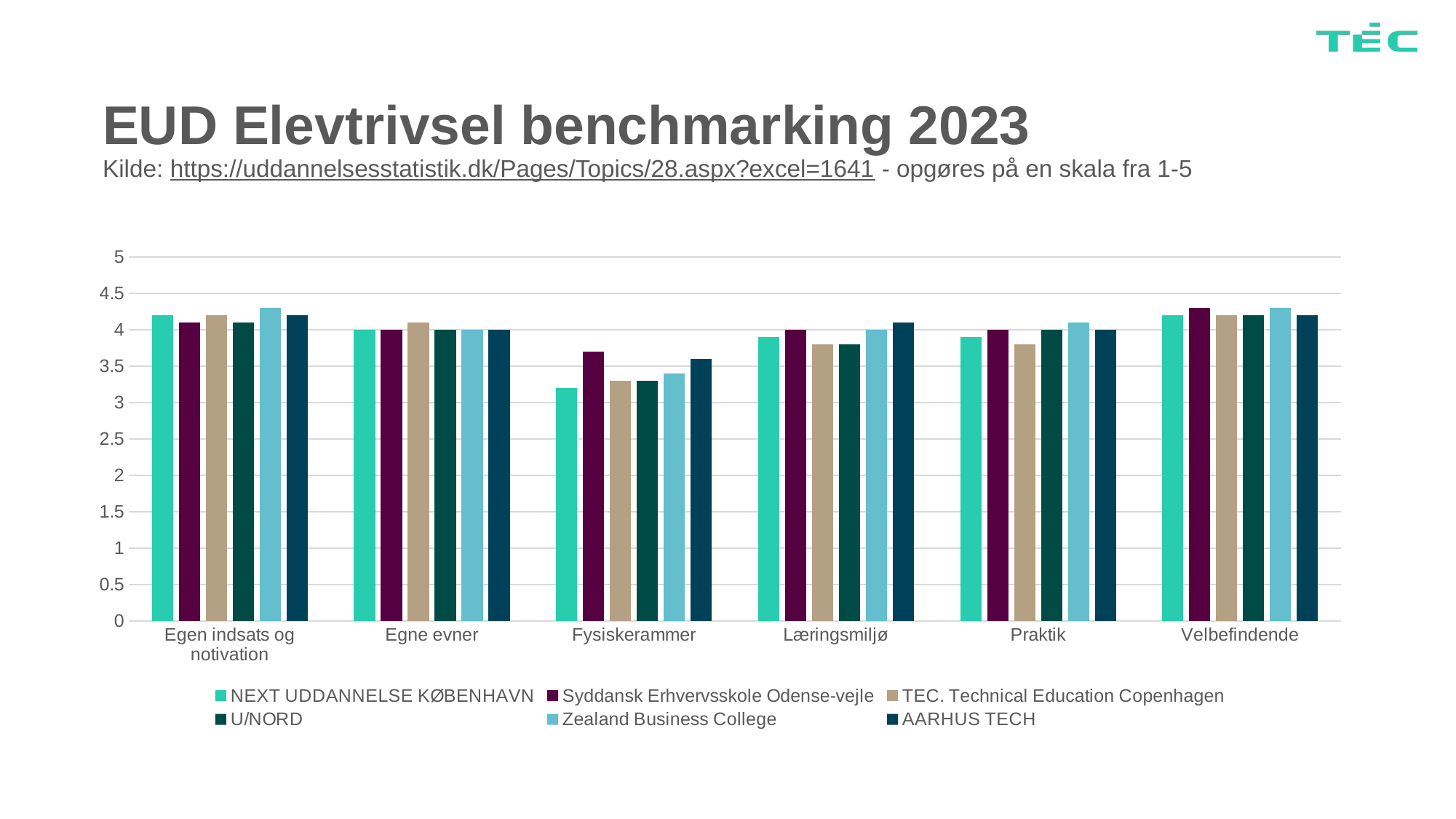
What kind of chart is shown on the slide? bar chart How many series does the chart's legend list? 6 In Fysiskerammer, which is larger: the value for NEXT UDDANNELSE KØBENHAVN or for Syddansk Erhvervsskole Odense-vejle? Syddansk Erhvervsskole Odense-vejle Is the value for Syddansk Erhvervsskole Odense-vejle in Velbefindende greater or less than 4? greater How many categories are shown on the x axis of the chart? 6 Which category has the lowest values overall across the schools? Fysiskerammer Is the value for NEXT UDDANNELSE KØBENHAVN in Fysiskerammer greater or less than 3.5? less What is the title of the slide containing the chart? EUD Elevtrivsel benchmarking 2023 Is the value for Zealand Business College in Egen indsats og notivation greater or less than 4? greater In Læringsmiljø, which is larger: the value for AARHUS TECH or for TEC. Technical Education Copenhagen? AARHUS TECH